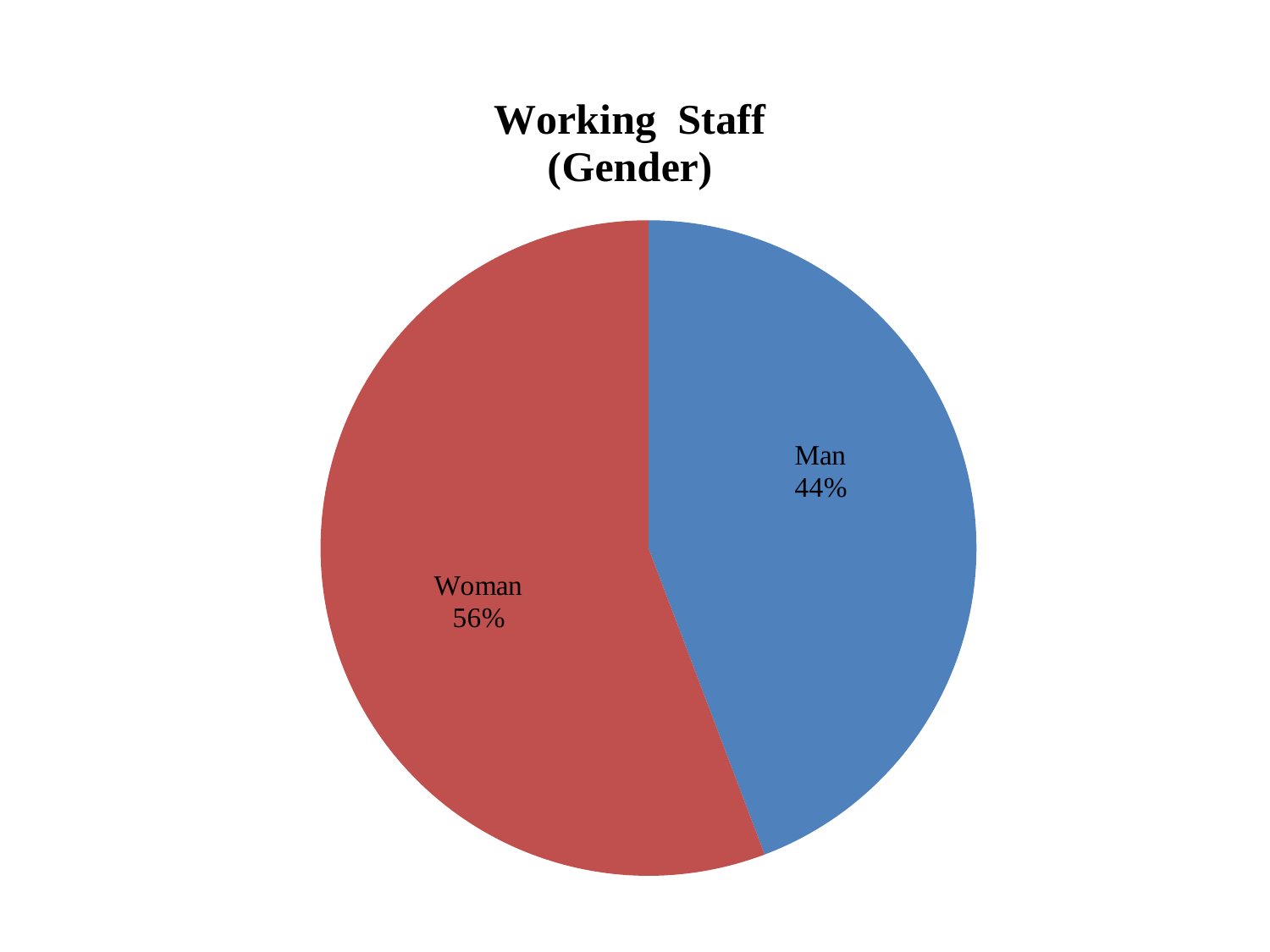
How many categories are shown in the pie chart? 2 Which category has the largest slice of the pie? Woman What colour is the Man slice? blue What is the title of the chart? Working Staff (Gender) Which category has the smallest slice of the pie? Man What share of the working staff is Man? 44% What is the difference in percentage points between the Woman and Man slices? 12 percentage points What share of the working staff is Woman? 56% What kind of chart is shown on the slide? pie chart Is the share for Woman greater or less than 50%? greater Which is larger, the Woman slice or the Man slice? Woman